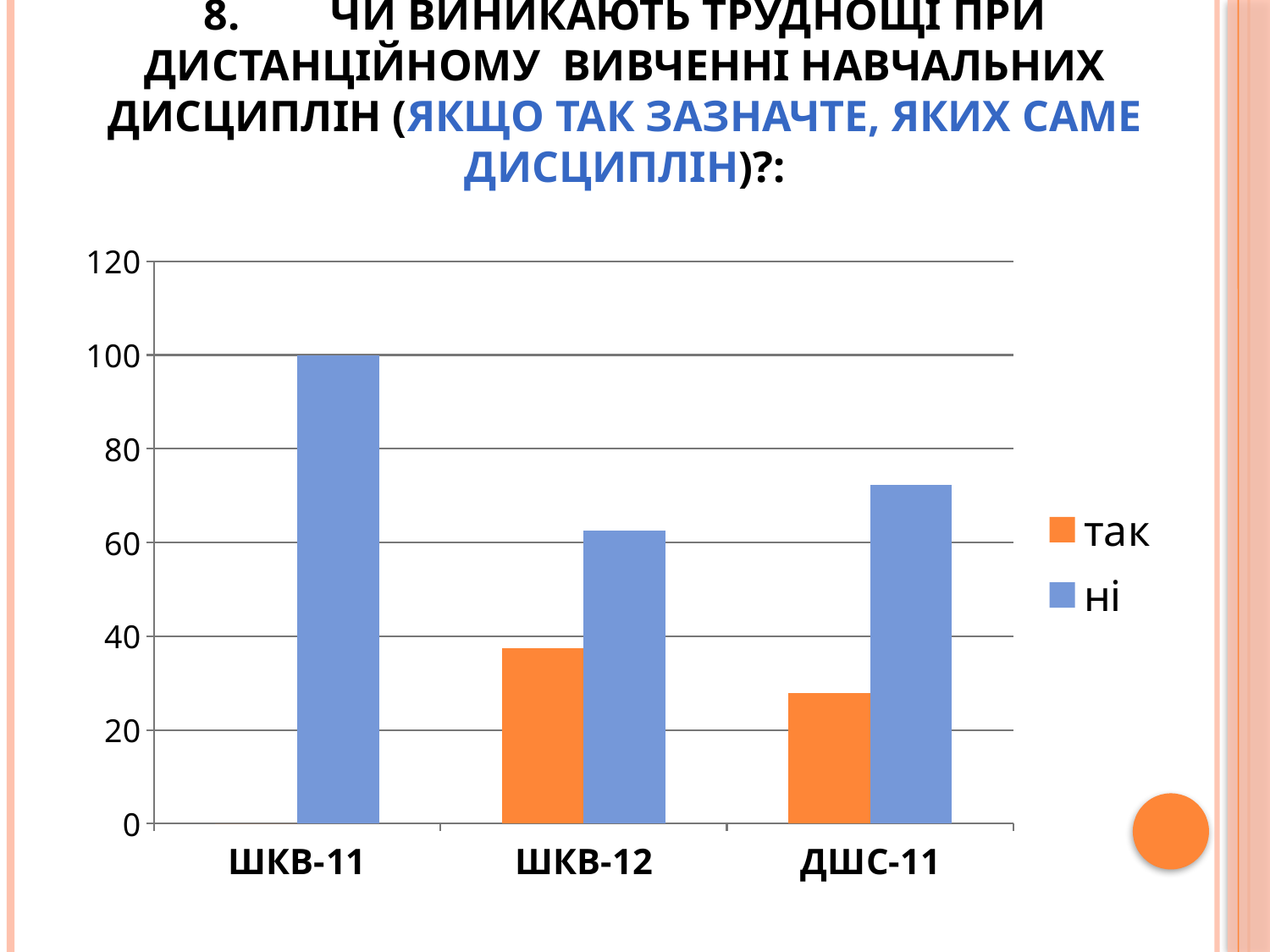
How many categories are shown on the x axis? 3 Is the value of "так" for ШКВ-12 greater or less than 40? less Which category has the highest value for "ні"? ШКВ-11 What kind of chart is shown on the slide? bar chart Which is larger for ШКВ-12: "так" or "ні"? ні What is the value of "ні" for ШКВ-11? 100 Is the value of "так" for ДШС-11 greater or less than 20? greater Which colour represents the "так" series in the legend? orange Does the value of "ні" rise or fall from ШКВ-11 to ШКВ-12? fall Is the value of "ні" for ДШС-11 greater or less than 60? greater Which category has the highest value for "так"? ШКВ-12 How many series does the legend list? 2